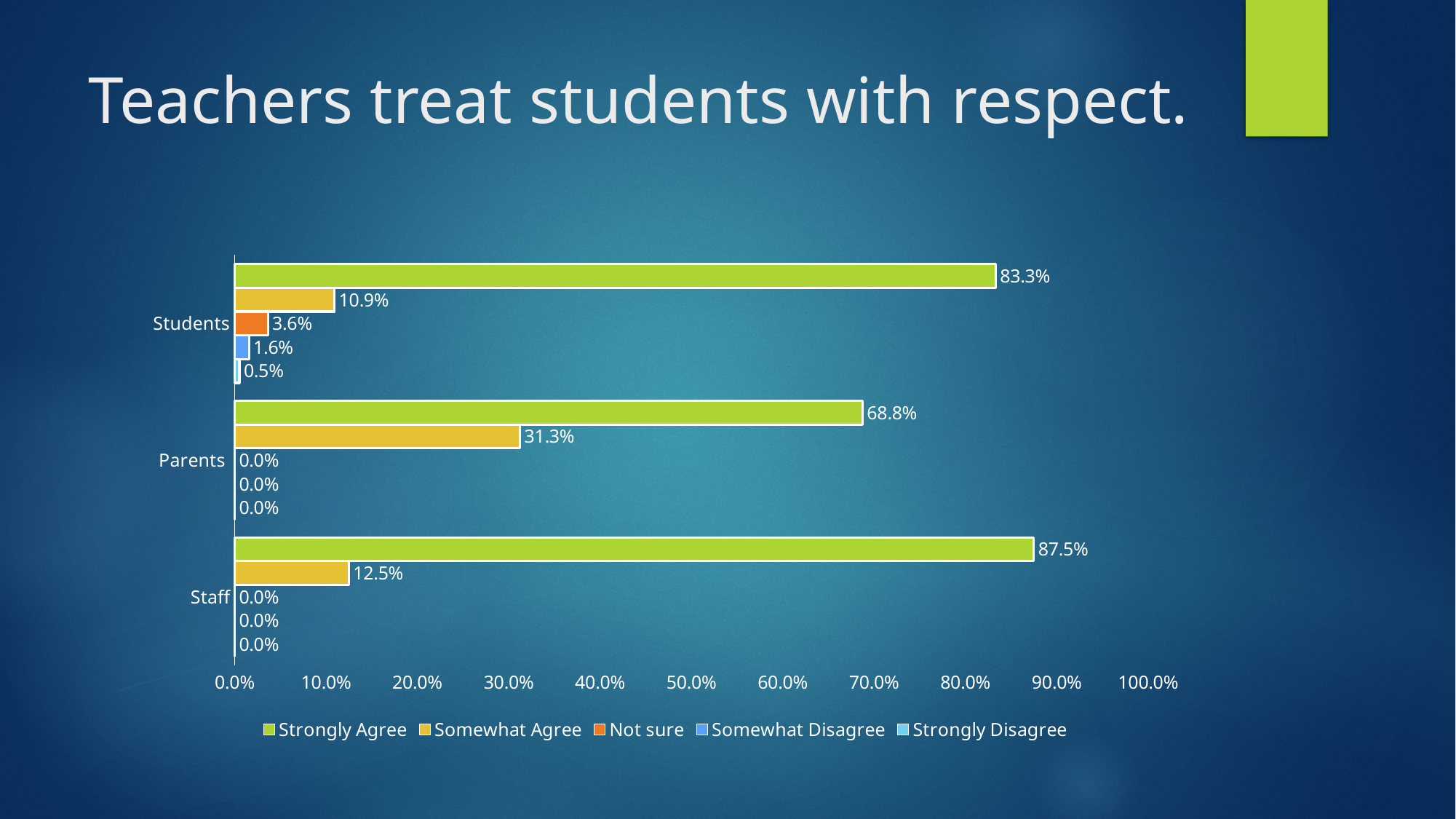
What type of chart is shown on the slide? Bar chart What is the difference between the Strongly Agree values for Staff and Parents? 18.7% What is the Somewhat Agree value for Parents? 31.3% How many series does the legend list? 5 Which is larger, the Somewhat Agree value for Parents or for Staff? Parents Which group has the lowest Strongly Agree percentage? Parents What is the title of the slide? Teachers treat students with respect. Which group has the highest Strongly Agree percentage? Staff What is the Not sure value for Students? 3.6% What percentage of Students Strongly Agree that teachers treat students with respect? 83.3% What is the Strongly Disagree value for Students? 0.5% How many groups are shown on the vertical axis? 3